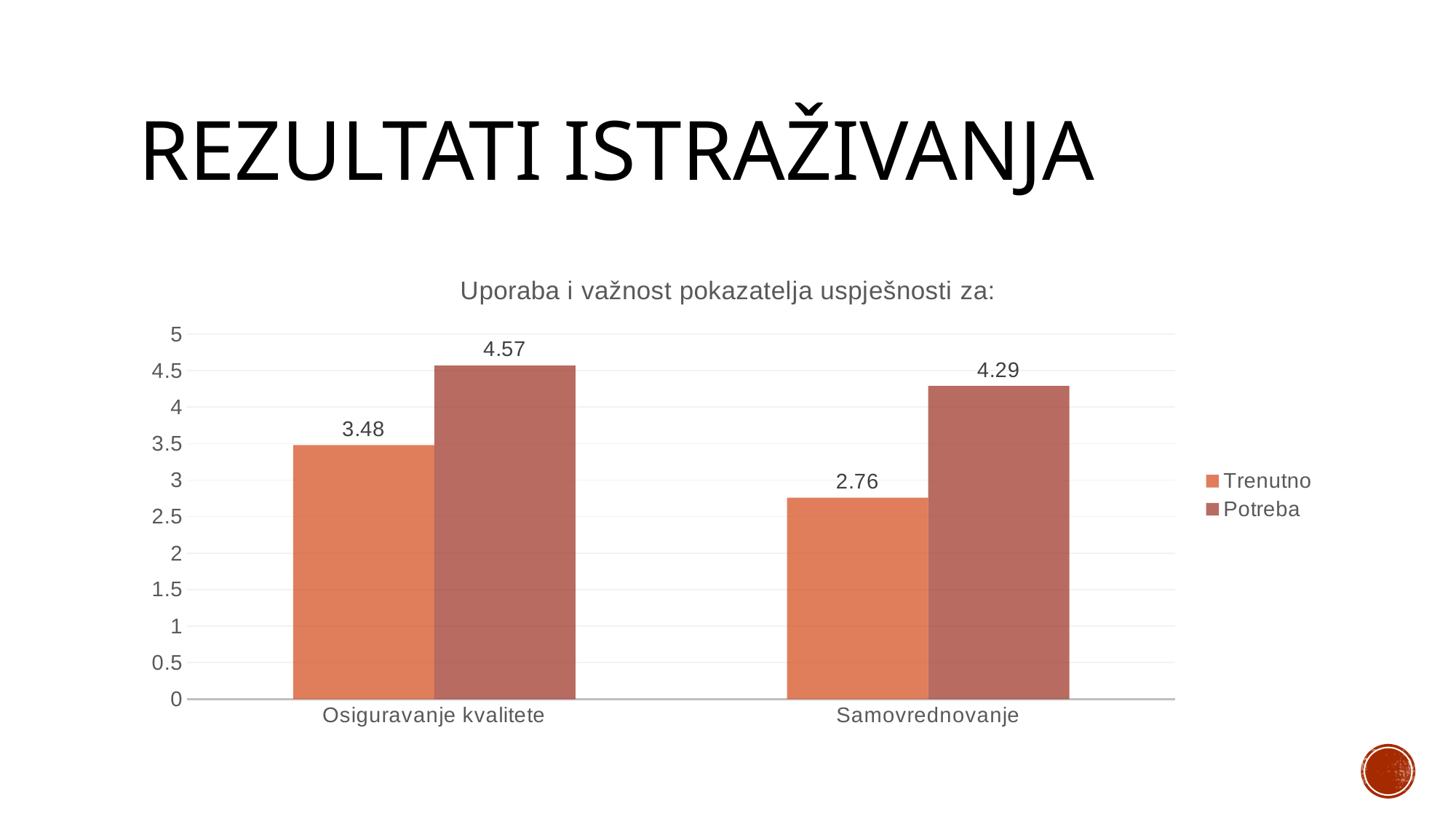
What is the Potreba value for Osiguravanje kvalitete? 4.57 How many categories are shown on the x axis? 2 Which category has the highest Potreba value? Osiguravanje kvalitete What is the Trenutno value for Samovrednovanje? 2.76 Which is larger for Samovrednovanje, Trenutno or Potreba? Potreba What is the Trenutno value for Osiguravanje kvalitete? 3.48 What is the difference between the Potreba and Trenutno values for Osiguravanje kvalitete? 1.09 What is the difference between the Potreba and Trenutno values for Samovrednovanje? 1.53 Which category has the lowest Trenutno value? Samovrednovanje What is the Potreba value for Samovrednovanje? 4.29 How many series does the legend list? 2 What kind of chart is shown on the slide? Bar chart